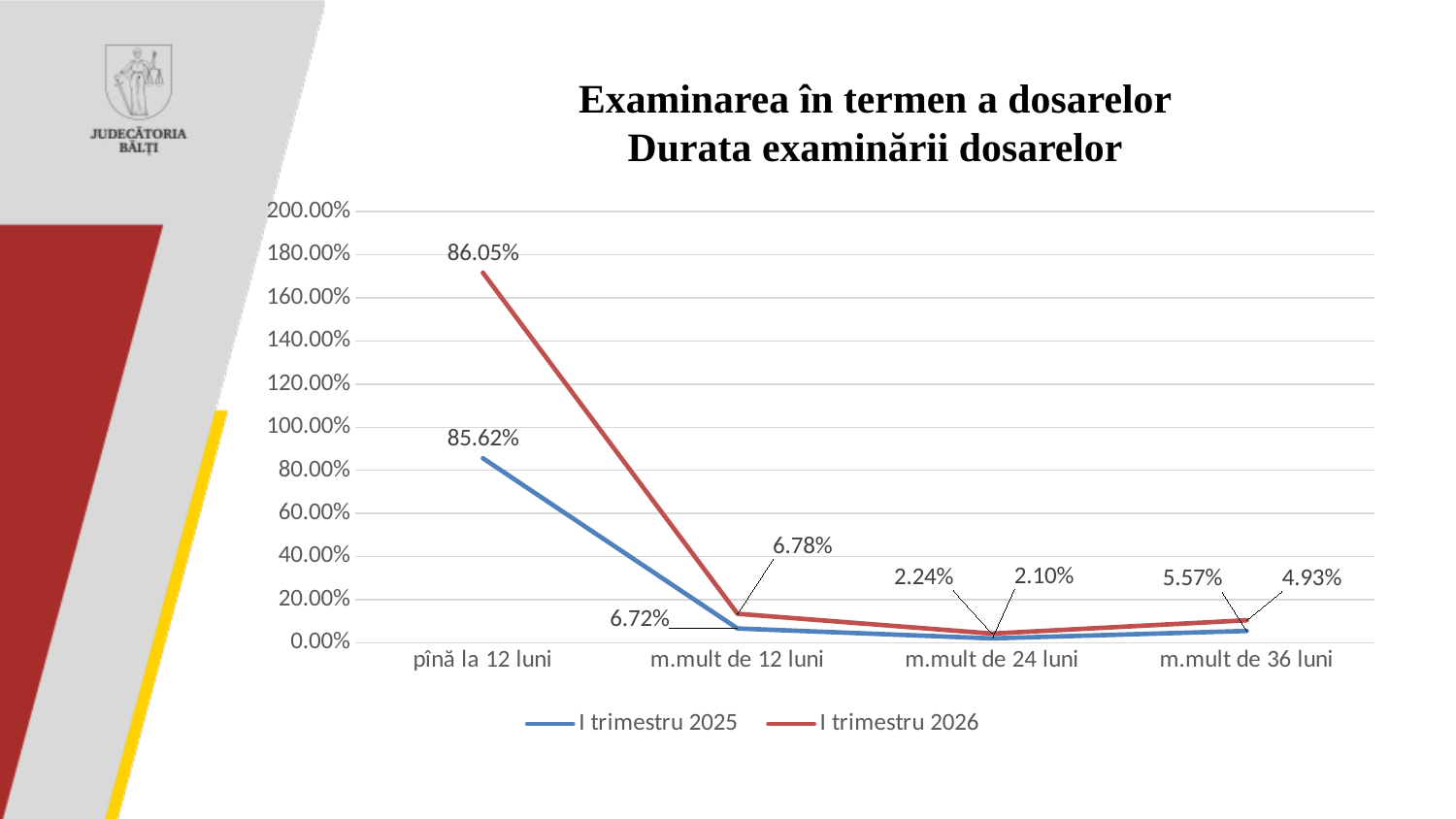
What is the title of the chart? Examinarea în termen a dosarelor Durata examinării dosarelor Which category has the lowest value in the I trimestru 2026 series? m.mult de 24 luni Which category has the highest value in the I trimestru 2025 series? pînă la 12 luni How many categories are shown on the x axis? 4 For 'm.mult de 12 luni', which series has the larger value, I trimestru 2025 or I trimestru 2026? I trimestru 2026 How many series does the legend list? 2 What is the value for 'pînă la 12 luni' in the I trimestru 2026 series? 86.05% What is the value for 'm.mult de 36 luni' in the I trimestru 2025 series? 5.57% What is the value for 'm.mult de 24 luni' in the I trimestru 2026 series? 2.24% What is the difference between the I trimestru 2026 and I trimestru 2025 values for 'm.mult de 36 luni'? 0.64% What type of chart is shown on the slide? line chart What is the value for 'pînă la 12 luni' in the I trimestru 2025 series? 85.62%